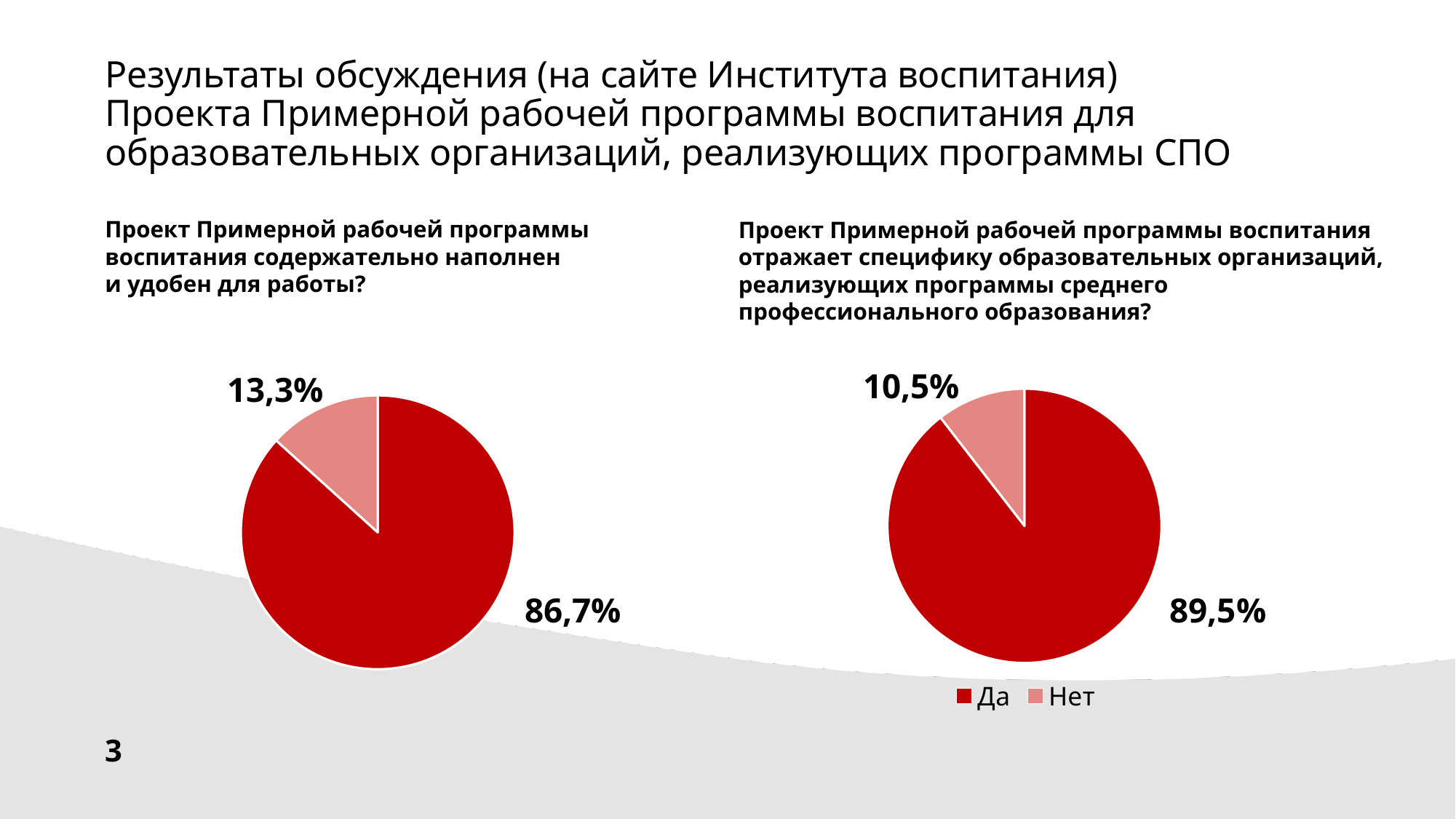
In the right pie chart, what share is labelled for the "Да" slice? 89,5% What kind of chart is the left chart on the slide? Pie chart How many slices does the right pie chart have? 2 How many entries does the legend below the right pie chart list? 2 In the left pie chart, which slice is the smallest? Нет In the left pie chart, what is the difference between the "Да" and "Нет" shares? 73,4% Which chart has the larger "Нет" share, the left pie chart or the right pie chart? The left pie chart In the left pie chart, what share is labelled for the "Нет" slice? 13,3% In the right pie chart, what is the difference between the "Да" and "Нет" shares? 79,0% In the left pie chart, what share is labelled for the "Да" slice? 86,7% In the right pie chart, what share is labelled for the "Нет" slice? 10,5% In the right pie chart, which slice is the largest? Да